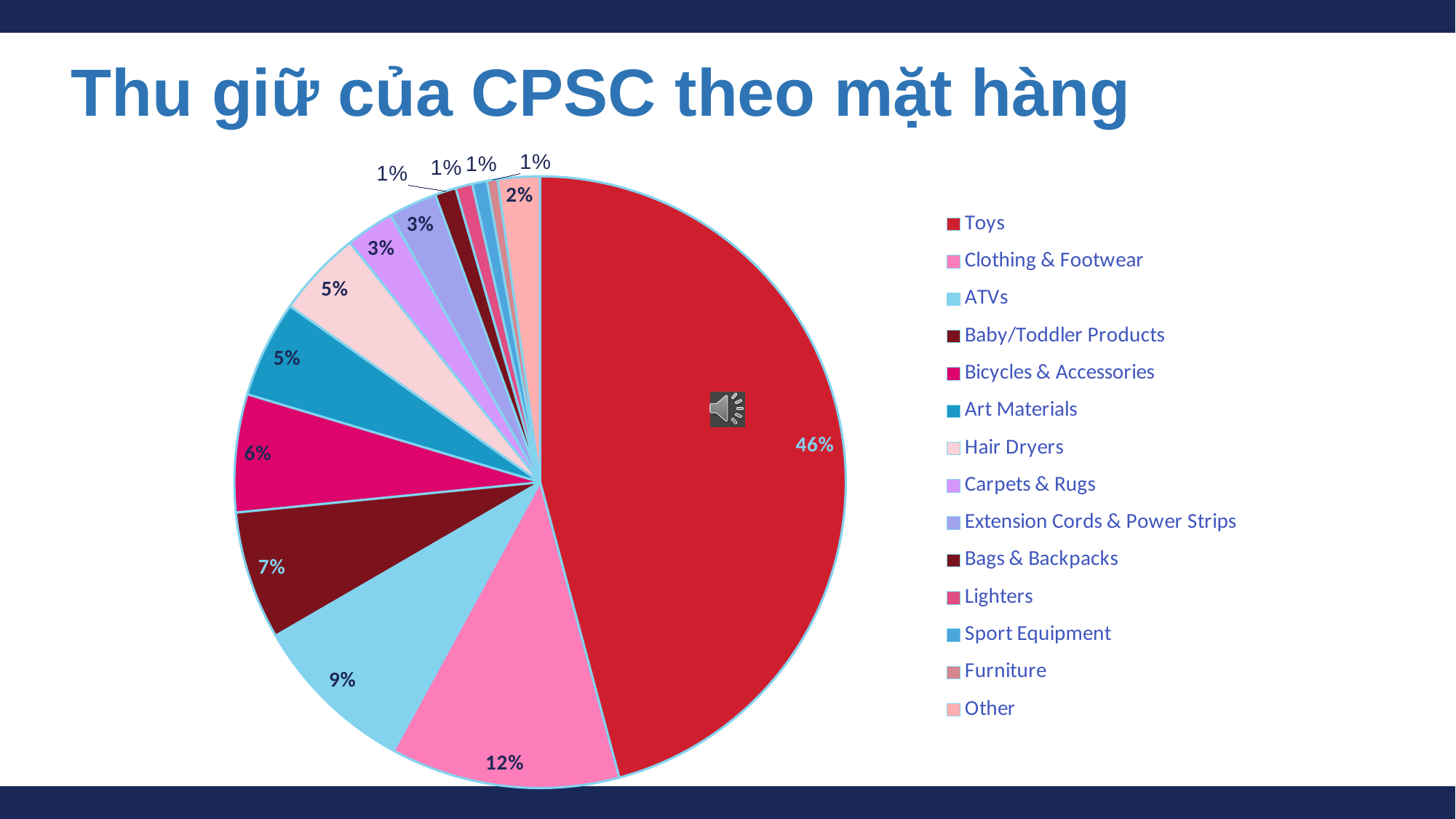
What is the value shown for Bicycles & Accessories? 6% What is the value shown for ATVs? 9% What is the difference between the shares for Toys and Clothing & Footwear? 34% What is the value shown for Other? 2% How many categories does the legend list? 14 Which is larger, the share for ATVs or the share for Baby/Toddler Products? ATVs What is the title of the chart on the slide? Thu giữ của CPSC theo mặt hàng What share of the pie does Toys account for? 46% What kind of chart is shown on the slide? pie chart Which category has the largest slice of the pie? Toys What share of the pie does Clothing & Footwear account for? 12% What is the value shown for Baby/Toddler Products? 7%